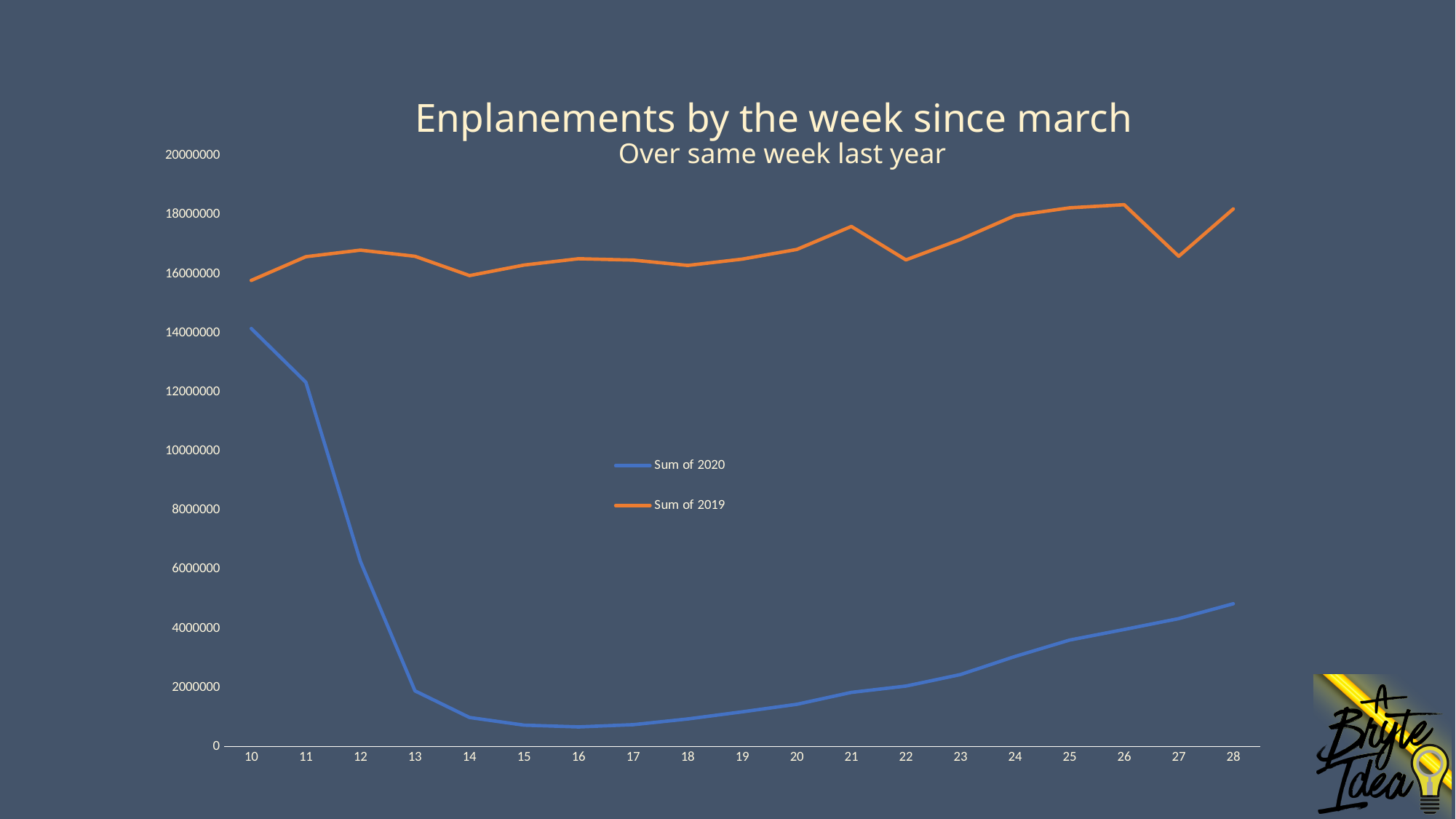
Is the Sum of 2019 value for week 27 greater or less than 18000000? less What is the title of the chart? Enplanements by the week since march Is the Sum of 2019 value for week 21 greater or less than 16000000? greater In which week is the Sum of 2020 value highest? 10 Is the Sum of 2020 value for week 14 greater or less than 2000000? less What kind of chart is shown on the slide? line chart Which series is drawn in orange? Sum of 2019 How many series does the legend list? 2 At week 20, which series has the larger value, Sum of 2020 or Sum of 2019? Sum of 2019 How many weeks are plotted along the x axis? 19 Does the Sum of 2020 line rise or fall from week 10 to week 14? fall